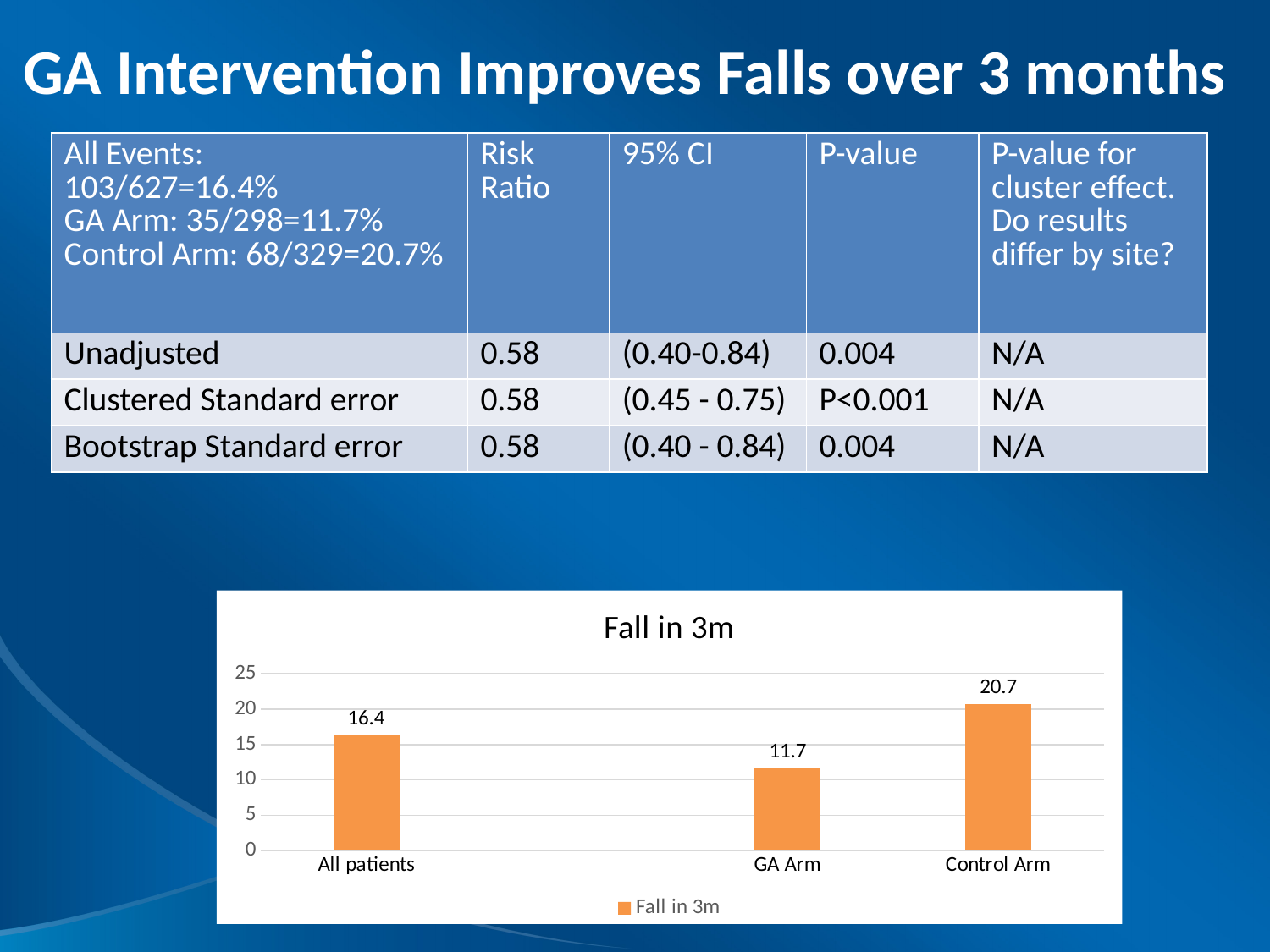
What is the value for All patients in the Fall in 3m chart? 16.4 How many series does the legend of the Fall in 3m chart list? 1 What is the difference between the All patients and GA Arm values in the Fall in 3m chart? 4.7 What is the value for Control Arm in the Fall in 3m chart? 20.7 What is the value for GA Arm in the Fall in 3m chart? 11.7 What kind of chart is the Fall in 3m chart? bar chart Is the value for Control Arm in the Fall in 3m chart greater or less than 20? greater Which is larger in the Fall in 3m chart, the value for GA Arm or the value for Control Arm? Control Arm Which category has the highest value in the Fall in 3m chart? Control Arm Which category has the lowest value in the Fall in 3m chart? GA Arm How many categories are shown in the Fall in 3m chart? 3 What is the difference between the Control Arm and GA Arm values in the Fall in 3m chart? 9.0